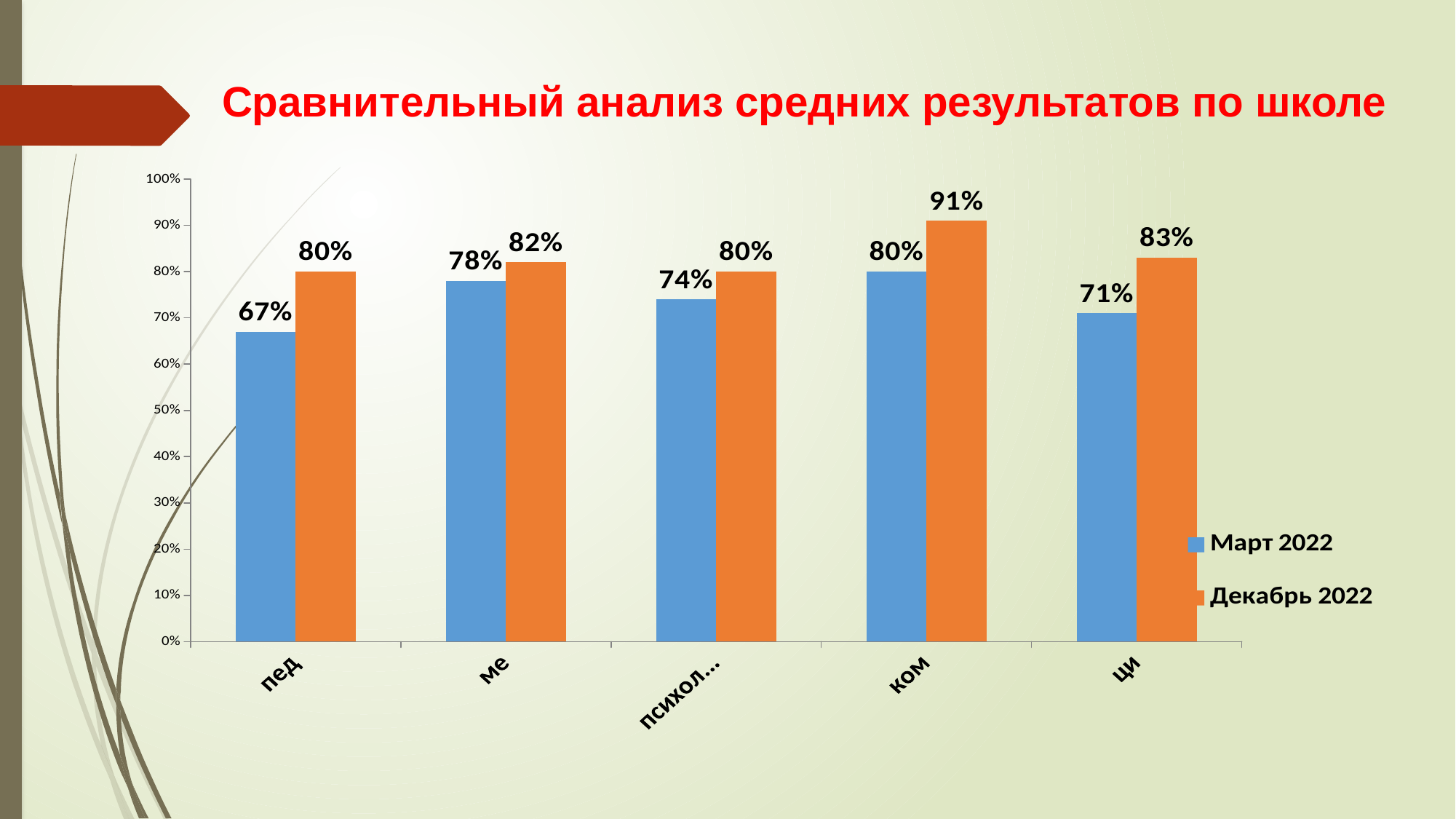
How many categories are shown on the x axis? 5 Which is larger for ци: the Март 2022 value or the Декабрь 2022 value? Декабрь 2022 What is the value for ци in the Март 2022 series? 71% What type of chart is shown on the slide? Bar chart What is the difference between the Декабрь 2022 and Март 2022 values for ком? 11% What is the difference between the Декабрь 2022 and Март 2022 values for пед? 13% How many series does the legend list? 2 What is the value for пед in the Март 2022 series? 67% What is the value for ком in the Декабрь 2022 series? 91% Which category has the highest value in the Декабрь 2022 series? ком What is the value for ме in the Декабрь 2022 series? 82% Which category has the lowest value in the Март 2022 series? пед